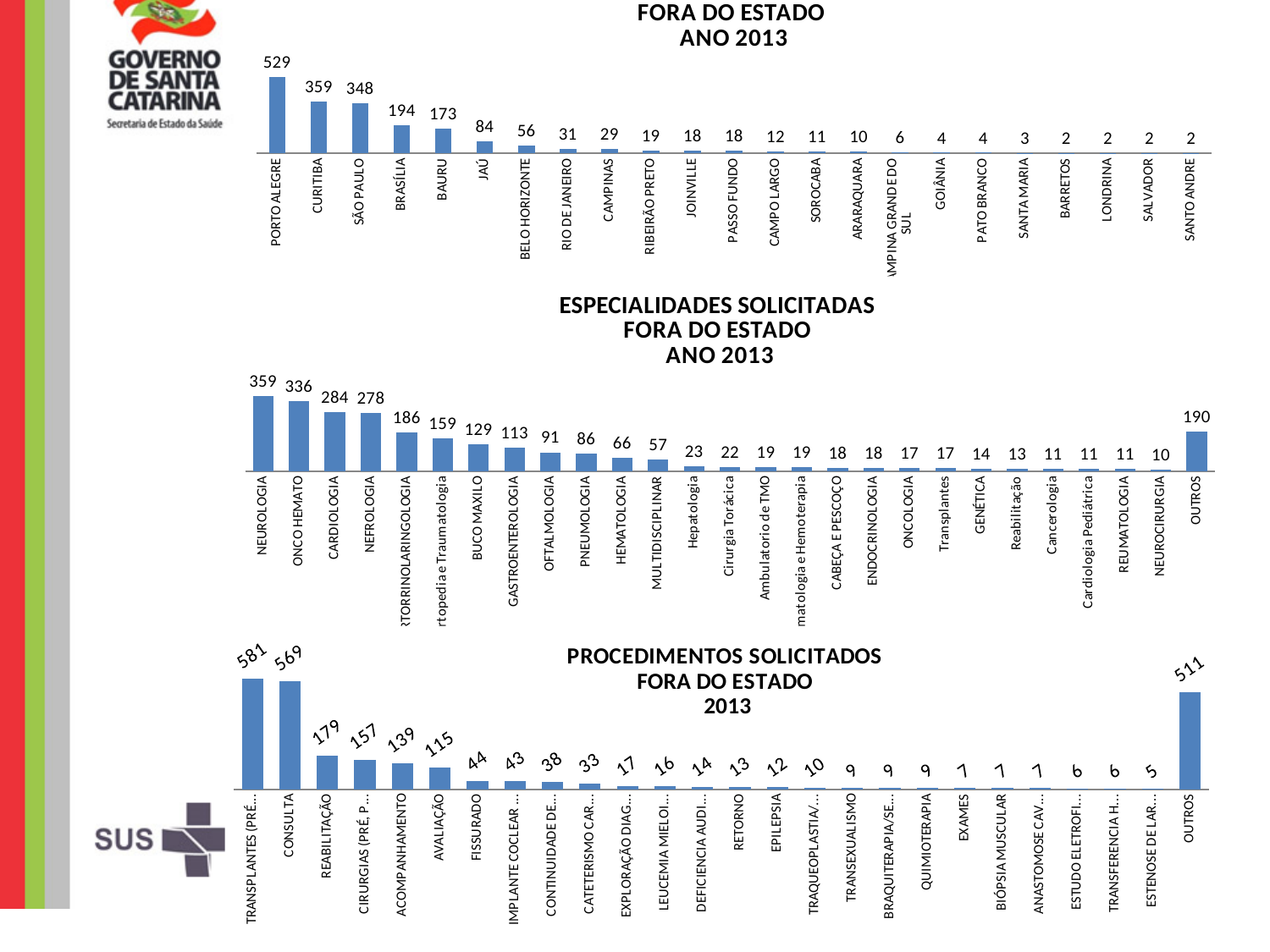
In the chart titled ESPECIALIDADES SOLICITADAS FORA DO ESTADO ANO 2013, what is the value for OUTROS? 190 In the top chart, which city has the lowest value among CURITIBA, SÃO PAULO and BRASÍLIA? BRASÍLIA In the chart titled ESPECIALIDADES SOLICITADAS FORA DO ESTADO ANO 2013, what is the difference between NEUROLOGIA and ONCO HEMATO? 23 What type of chart is the chart titled PROCEDIMENTOS SOLICITADOS FORA DO ESTADO 2013? Bar chart In the chart titled ESPECIALIDADES SOLICITADAS FORA DO ESTADO ANO 2013, which is larger, CARDIOLOGIA or NEFROLOGIA? CARDIOLOGIA In the top chart, what is the value for PORTO ALEGRE? 529 In the chart titled PROCEDIMENTOS SOLICITADOS FORA DO ESTADO 2013, what is the difference between REABILITAÇÃO and AVALIAÇÃO? 64 In the chart titled PROCEDIMENTOS SOLICITADOS FORA DO ESTADO 2013, what is the value for OUTROS? 511 In the top chart, what is the value for JOINVILLE? 18 In the chart titled PROCEDIMENTOS SOLICITADOS FORA DO ESTADO 2013, what is the value for CONSULTA? 569 In the chart titled ESPECIALIDADES SOLICITADAS FORA DO ESTADO ANO 2013, which specialty has the highest value? NEUROLOGIA In the top chart, what is the difference between the values for CURITIBA and SÃO PAULO? 11